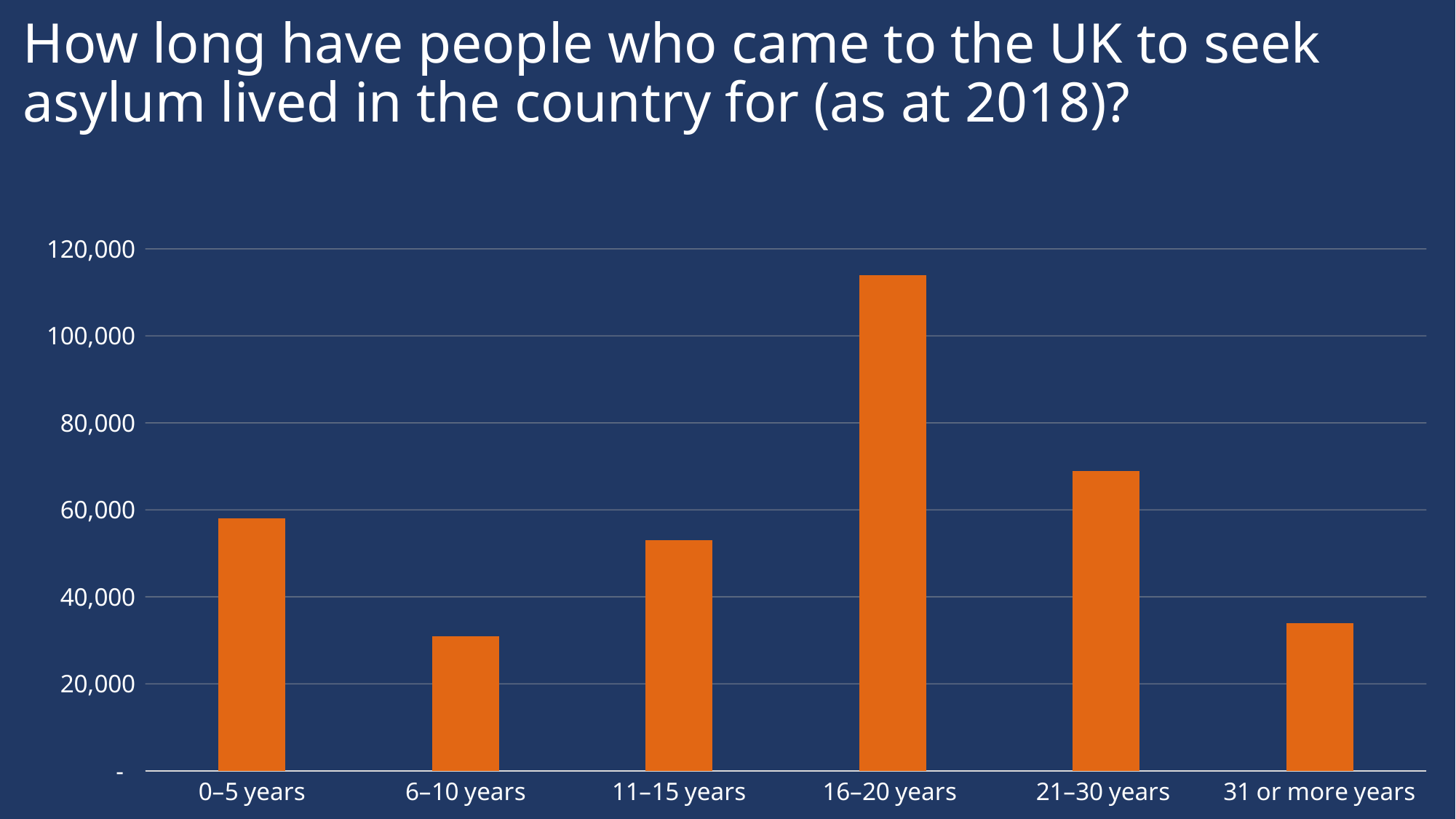
Is the value for 16–20 years greater or less than 100,000? greater Is the value for 11–15 years greater or less than 40,000? greater Which is larger, the value for 21–30 years or the value for 31 or more years? 21–30 years How many categories (length-of-stay groups) are shown on the x axis? 6 Is the value for 6–10 years greater or less than 40,000? less What kind of chart is shown on the slide? bar chart Which is larger, the value for 0–5 years or the value for 11–15 years? 0–5 years Do the values rise or fall from 6–10 years to 16–20 years? rise What is the title of the chart? How long have people who came to the UK to seek asylum lived in the country for (as at 2018)? Which length-of-stay group has the highest value? 16–20 years